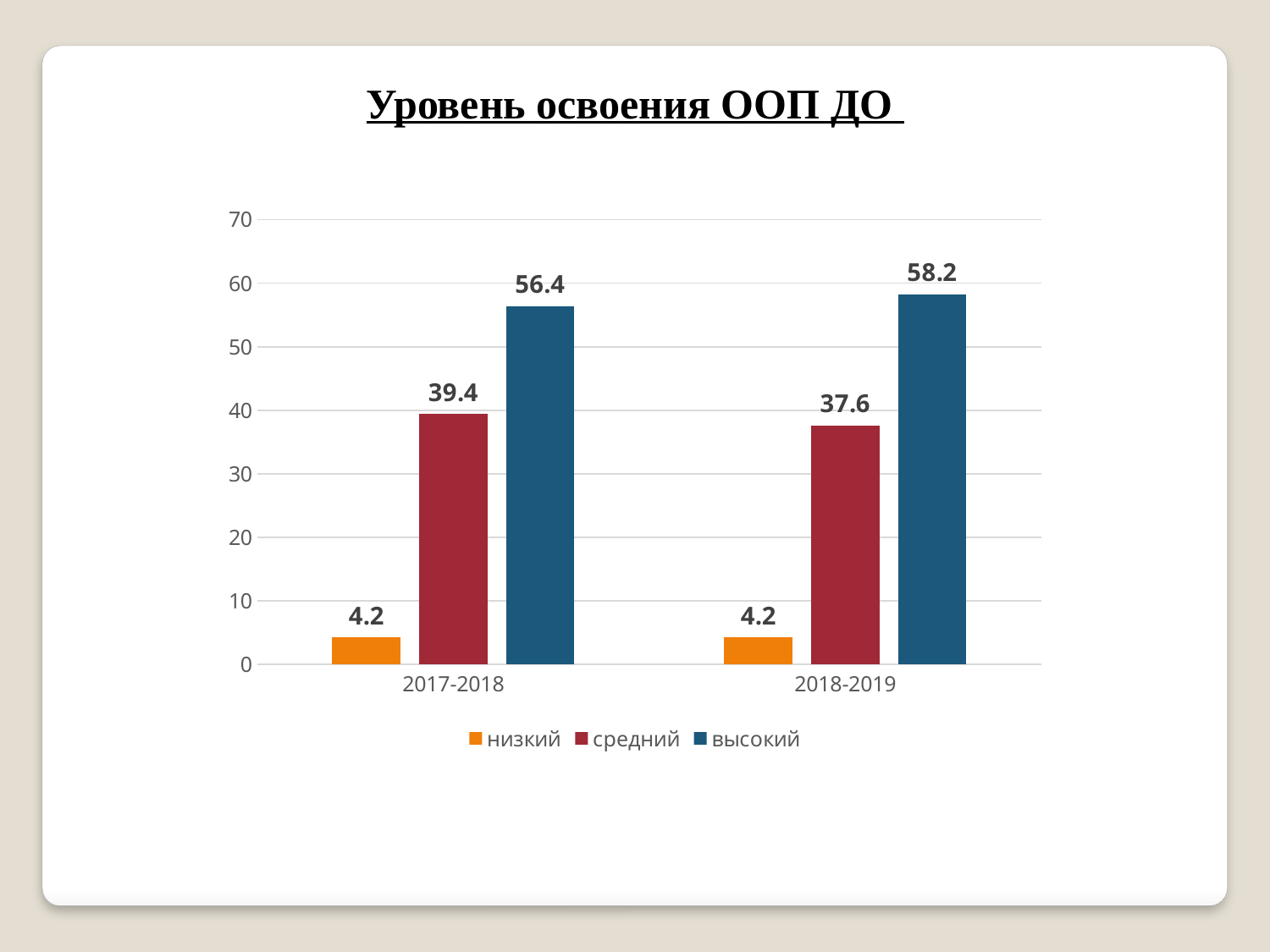
What is the difference between the средний and низкий values in 2017-2018? 35.2 What is the value for средний in 2018-2019? 37.6 Which is larger: средний in 2017-2018 or средний in 2018-2019? средний in 2017-2018 What is the value for низкий in 2017-2018? 4.2 Which series has the lowest value in 2017-2018? низкий How many categories are shown on the x axis? 2 What kind of chart is shown on the slide? bar chart What is the difference between the высокий values for 2018-2019 and 2017-2018? 1.8 Which series has the highest value in 2018-2019? высокий What is the value for высокий in 2017-2018? 56.4 How many series does the legend list? 3 What is the title of the slide? Уровень освоения ООП ДО